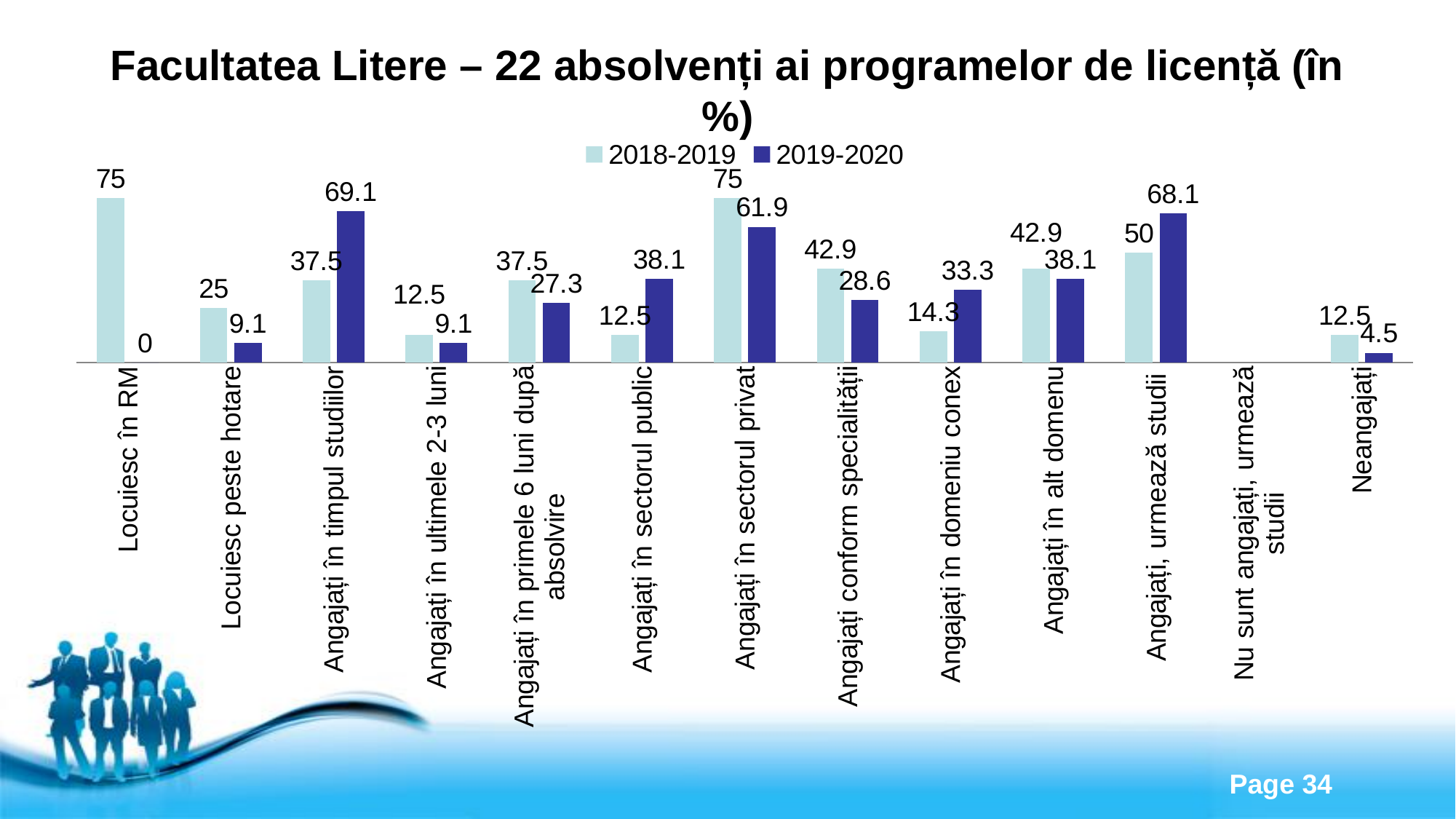
Which series is shown in dark blue? 2019-2020 What is the 2019-2020 value for "Angajați în timpul studiilor"? 69.1 Which category has the lowest 2019-2020 value? Locuiesc în RM What kind of chart is shown on the slide? Bar chart What is the 2018-2019 value for "Angajați conform specialității"? 42.9 For "Angajați în sectorul privat", which series has the larger value, 2018-2019 or 2019-2020? 2018-2019 What is the 2019-2020 value for "Neangajați"? 4.5 What is the difference between the 2018-2019 and 2019-2020 values for "Angajați în sectorul public"? 25.6 What is the 2019-2020 value for "Locuiesc în RM"? 0 How many categories are shown on the x axis? 13 Which category has the highest 2019-2020 value? Angajați în timpul studiilor How many series does the legend list? 2